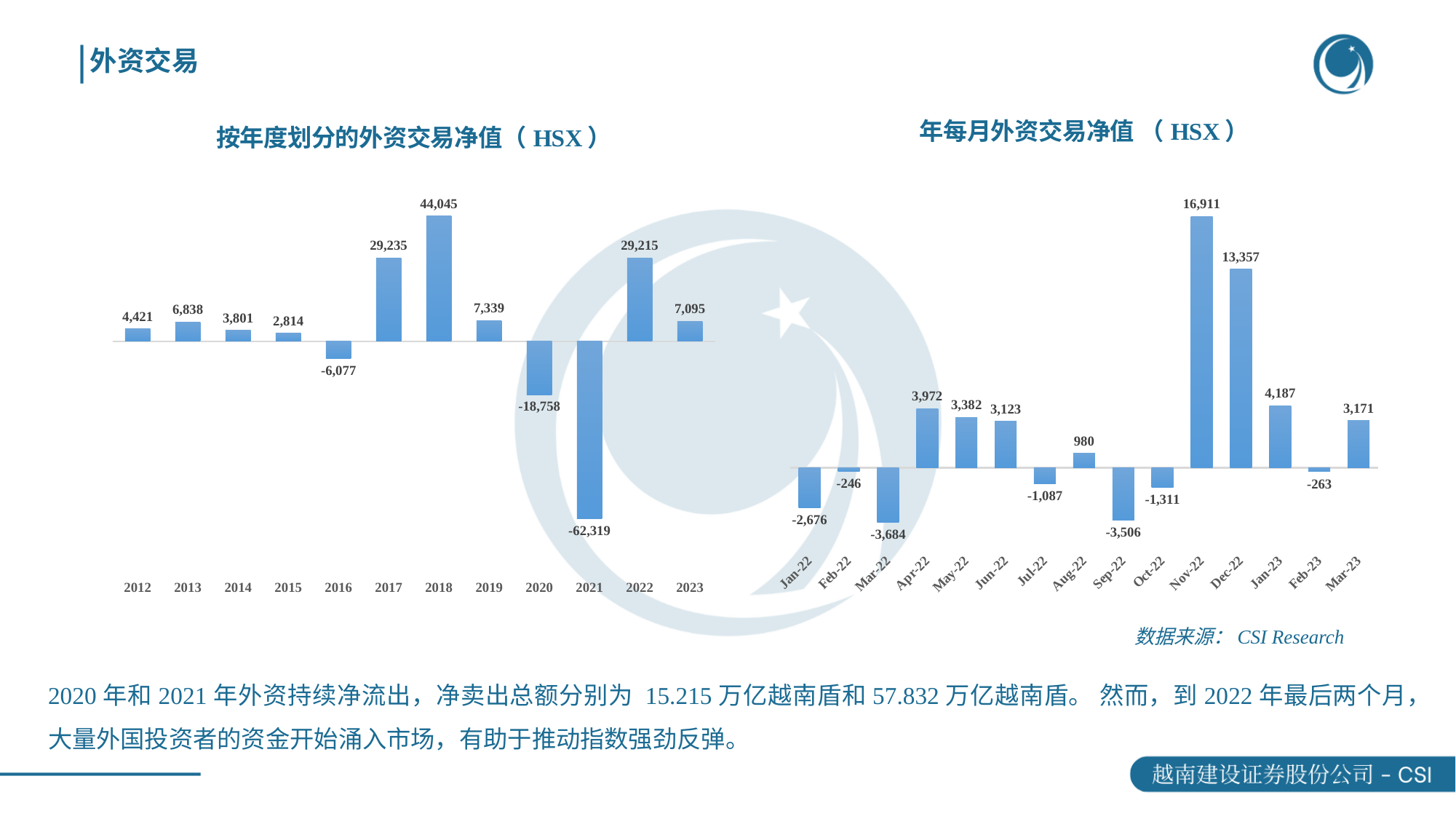
In the right chart (年每月外资交易净值), which month has the lowest value? Mar-22 What type of chart is the right chart (年每月外资交易净值)? Bar chart In the right chart (年每月外资交易净值), what is the difference between the values for Nov-22 and Dec-22? 3,554 In the left chart (按年度划分的外资交易净值), which year has the lowest value? 2021 In the left chart (按年度划分的外资交易净值), how many years are shown on the x axis? 12 In the left chart (按年度划分的外资交易净值), which year has the highest value? 2018 In the left chart (按年度划分的外资交易净值), what is the difference between the values for 2018 and 2017? 14,810 In the right chart (年每月外资交易净值), which is larger, the value for Apr-22 or the value for Jan-23? Jan-23 In the right chart (年每月外资交易净值), what is the value for Sep-22? -3,506 In the left chart (按年度划分的外资交易净值), what is the value for 2021? -62,319 In the right chart (年每月外资交易净值), what is the value for Nov-22? 16,911 In the left chart (按年度划分的外资交易净值), what is the value for 2018? 44,045